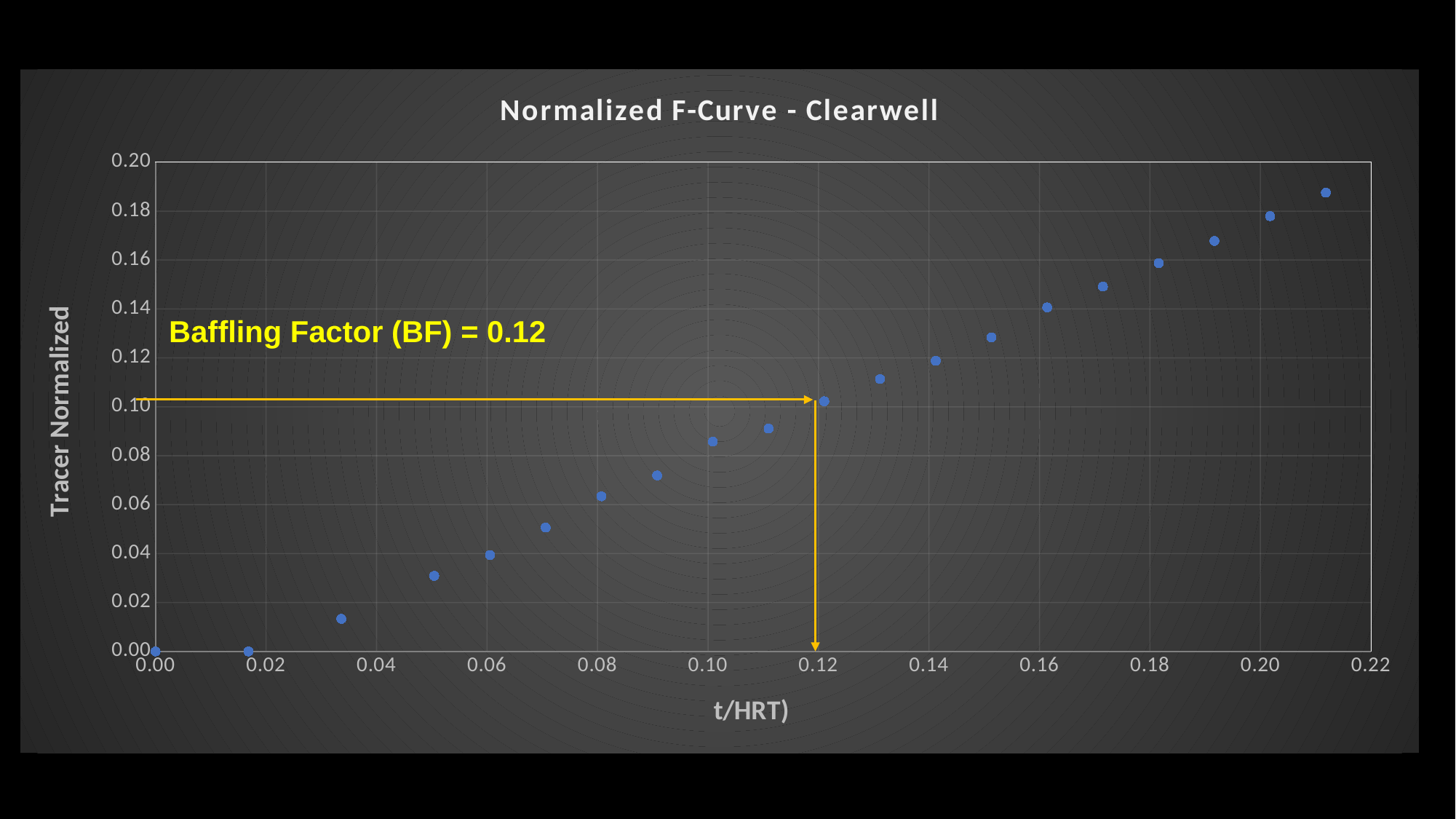
Is the Tracer Normalized value at t/HRT = 0.20 greater or less than 0.16? greater Is the Tracer Normalized value at t/HRT = 0.06 greater or less than 0.06? less Is the Tracer Normalized value at t/HRT = 0.16 greater or less than 0.12? greater What kind of chart is shown on the slide? scatter chart Which has the larger Tracer Normalized value: the point at t/HRT = 0.10 or the point at t/HRT = 0.20? t/HRT = 0.20 How many data points are plotted on the chart? 20 What is the title of the chart? Normalized F-Curve - Clearwell Do the plotted values rise or fall as t/HRT increases along the x axis? rise What Baffling Factor (BF) value is annotated on the chart? 0.12 What is the label of the y axis? Tracer Normalized